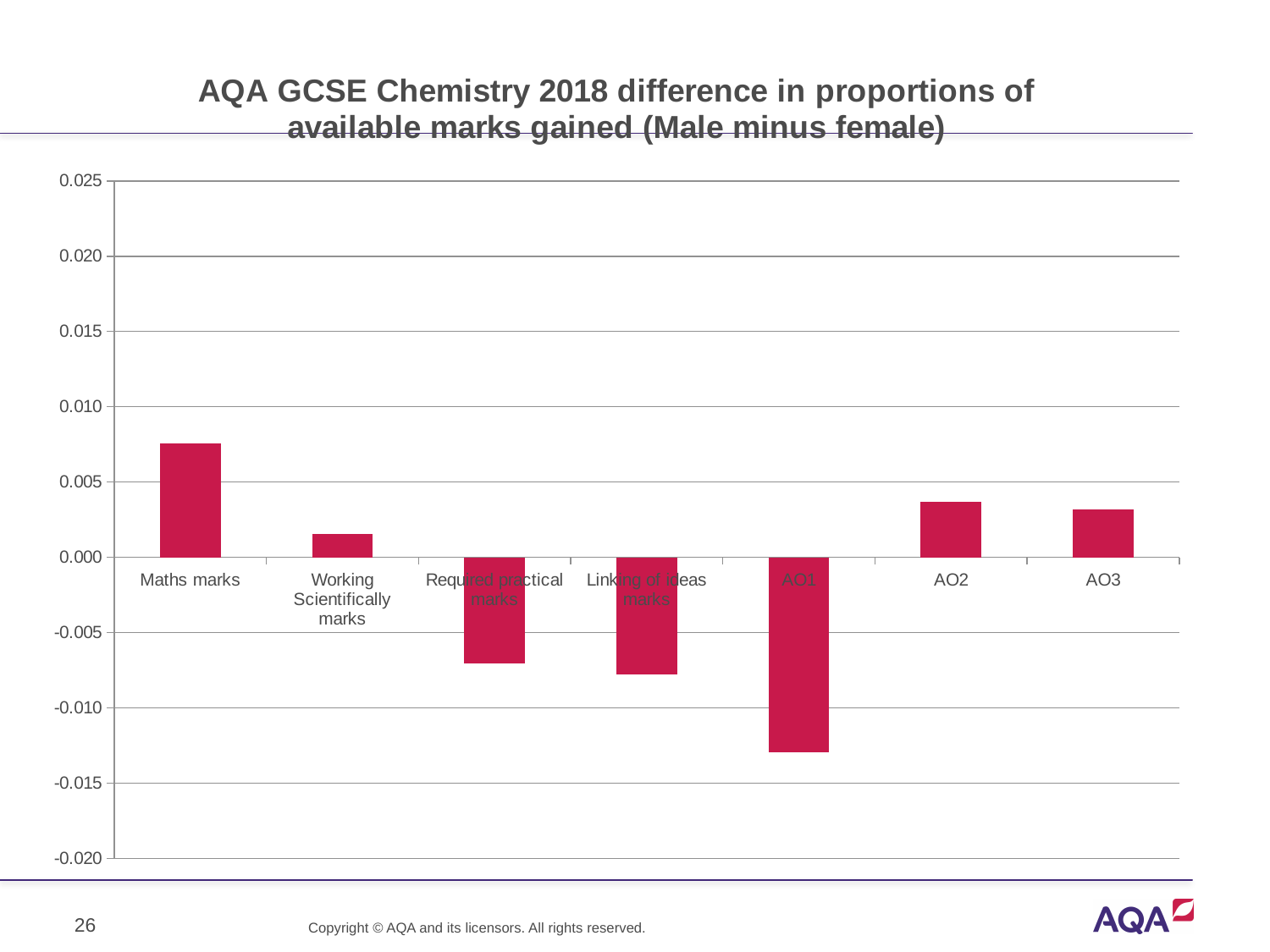
Is the value for Required practical marks greater or less than -0.005? less Which category has the highest value on the chart? Maths marks Which is larger, the value for Maths marks or the value for Working Scientifically marks? Maths marks How many categories have a negative value on the chart? 3 Is the value for AO1 greater or less than -0.010? less Which is larger, the value for AO2 or the value for AO1? AO2 What is the title of the chart? AQA GCSE Chemistry 2018 difference in proportions of available marks gained (Male minus female) How many categories are plotted on the chart? 7 What kind of chart is shown on the slide? Bar chart Is the value for Working Scientifically marks greater or less than 0.005? less Which category has the lowest value on the chart? AO1